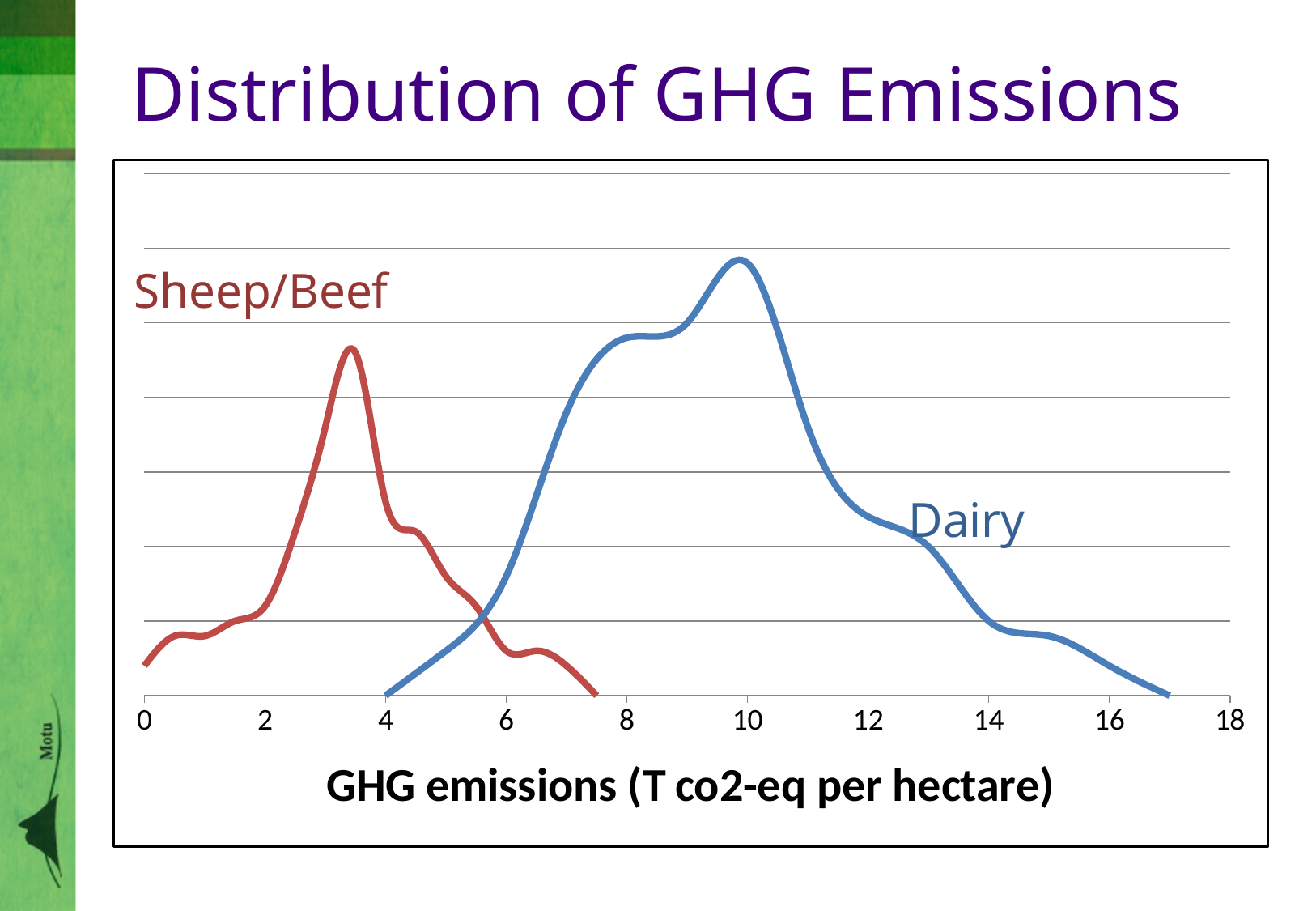
Does the Dairy curve rise or fall between 4 and 10 on the x axis? rise What is the label of the x axis? GHG emissions (T co2-eq per hectare) At what GHG emissions value does the Dairy curve begin on the x axis? 4 What is the title of the slide's chart? Distribution of GHG Emissions How many series are plotted on the chart? 2 Which series has its peak at the lower GHG emissions value? Sheep/Beef What is the highest value shown on the x axis? 18 What kind of chart is shown on the slide? Line chart How many tick labels are shown on the x axis? 10 Is the GHG emissions value at the peak of the Sheep/Beef curve greater or less than 4? less Which series reaches the higher peak, Sheep/Beef or Dairy? Dairy Is the GHG emissions value at the peak of the Dairy curve greater or less than 8? greater